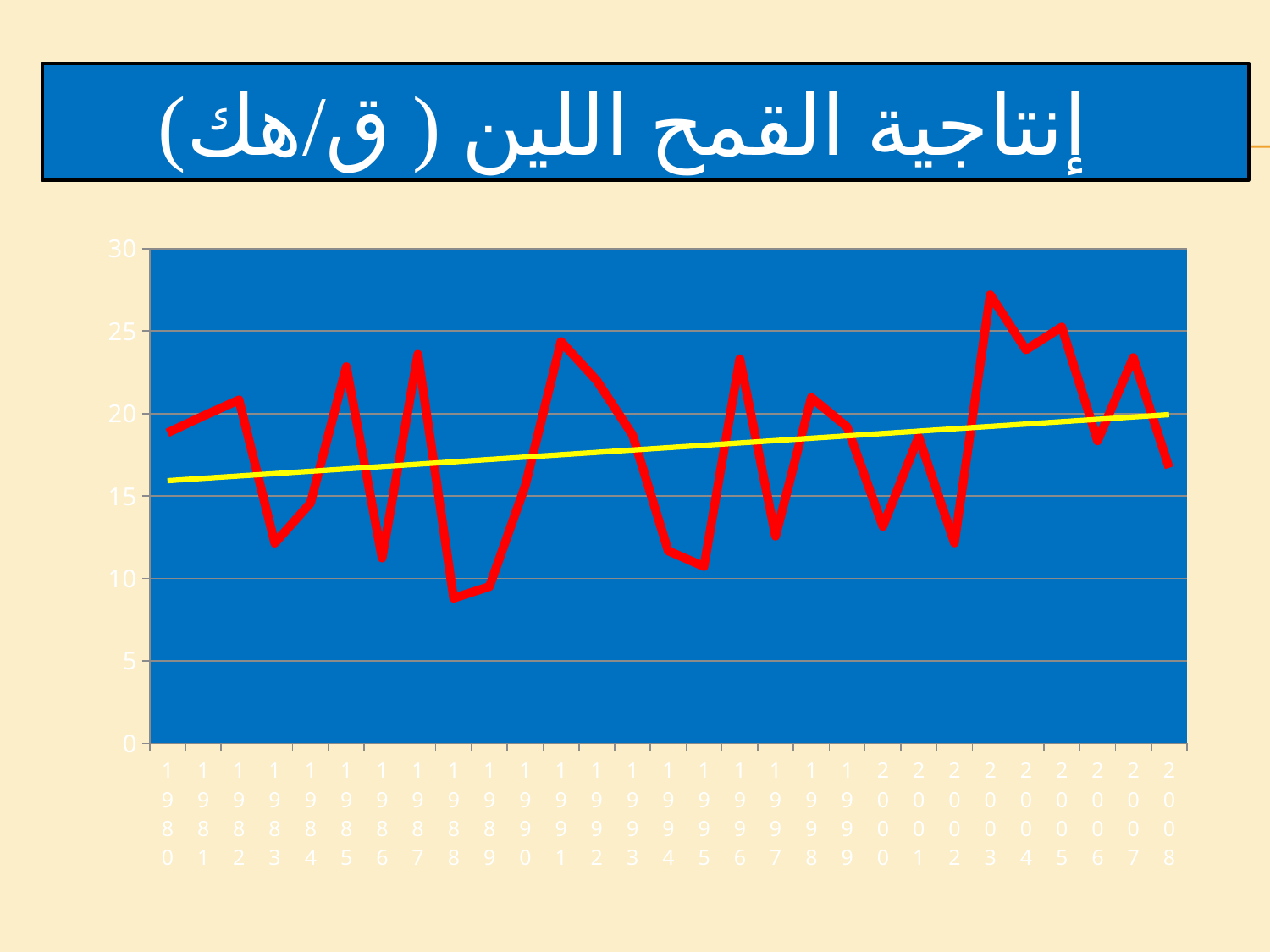
What kind of chart is shown on the slide? line chart Does the yellow trend line rise or fall from 1980 to 2008? rise Is the value for 1988 greater or less than 10? less Is the value for 1995 greater or less than 15? less In which year does the red line reach its highest value? 2003 Is the value for 1980 greater or less than 20? less What is the first year shown on the x axis? 1980 How many years are plotted along the x axis? 29 Which year has the larger value, 1985 or 1986? 1985 What is the last year shown on the x axis? 2008